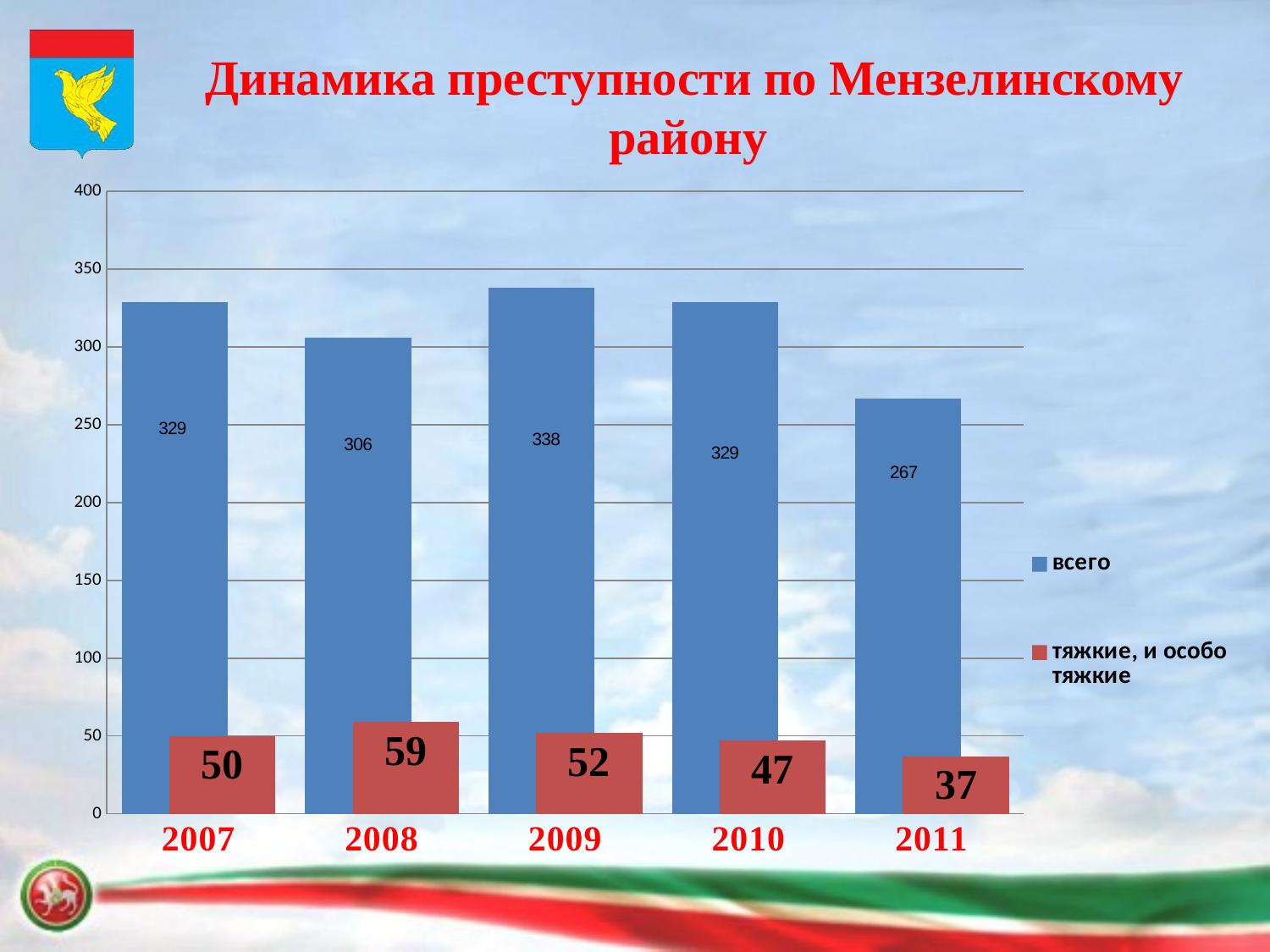
How many years are shown on the x axis? 5 What is the value of the "тяжкие, и особо тяжкие" series for 2011? 37 Which year has the highest value for the "всего" series? 2009 What kind of chart is shown on the slide? bar chart What is the value of the "всего" series for 2009? 338 How many series does the legend list? 2 Which year has the highest value for the "тяжкие, и особо тяжкие" series? 2008 Which year has the lowest value for the "тяжкие, и особо тяжкие" series? 2011 Which is larger: the "всего" value for 2008 or for 2010? 2010 What is the difference between the "тяжкие, и особо тяжкие" values for 2008 and 2011? 22 What is the value of the "всего" series for 2011? 267 What is the difference between the "всего" values for 2009 and 2011? 71